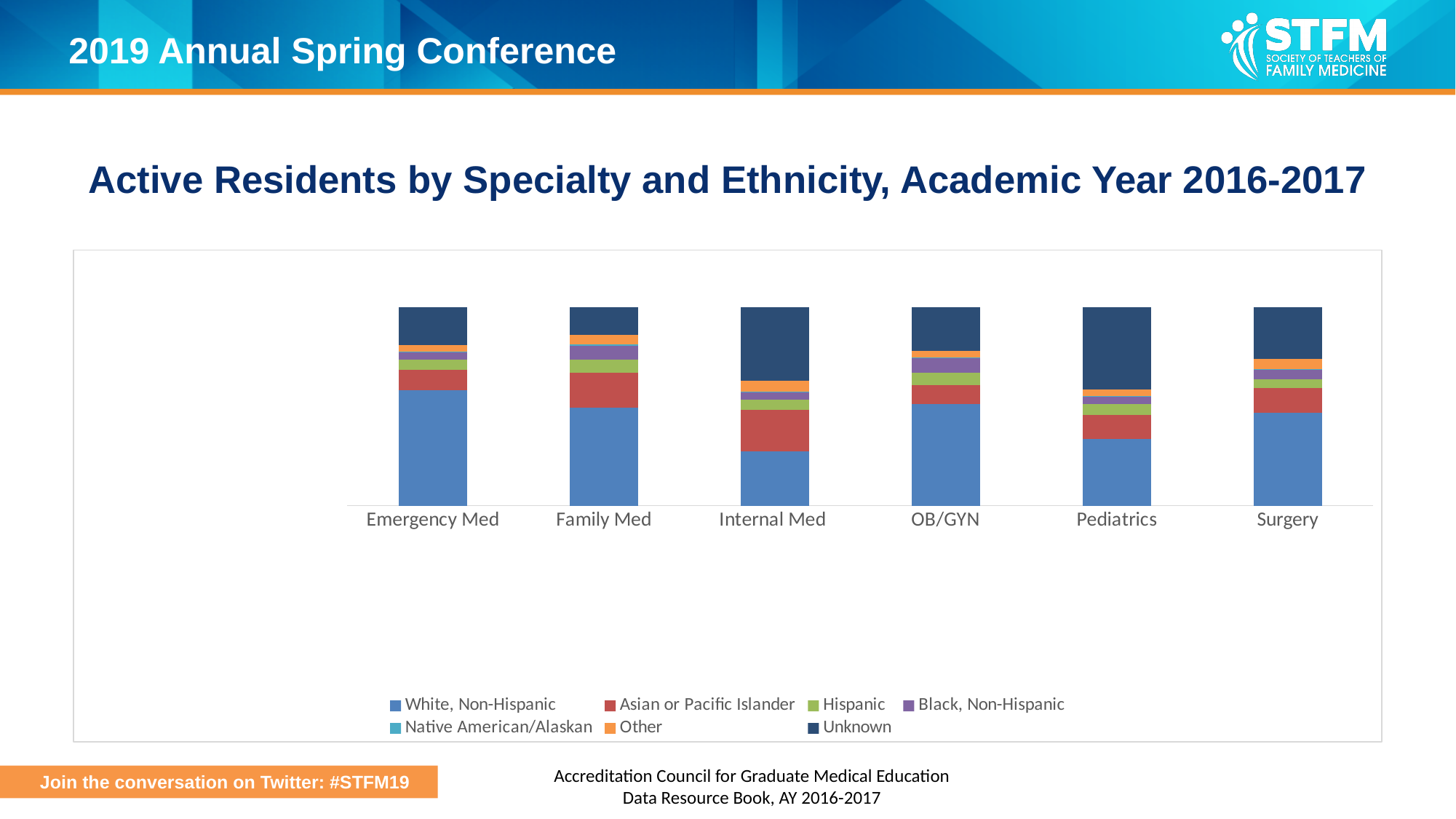
Which legend entry is shown in dark navy? Unknown How many specialties are shown along the x axis of the chart? 6 Which specialty has the largest White, Non-Hispanic segment? Emergency Med Is the Unknown segment larger for Pediatrics or for Emergency Med? Pediatrics How many series does the chart's legend list? 7 What kind of chart is shown on the slide? Stacked bar chart Which specialty has the smallest White, Non-Hispanic segment? Internal Med Is the Asian or Pacific Islander segment larger for Internal Med or for Emergency Med? Internal Med Which specialty is shown in the leftmost bar of the chart? Emergency Med Is the Unknown segment larger for Internal Med or for Family Med? Internal Med What is the title of the chart? Active Residents by Specialty and Ethnicity, Academic Year 2016-2017